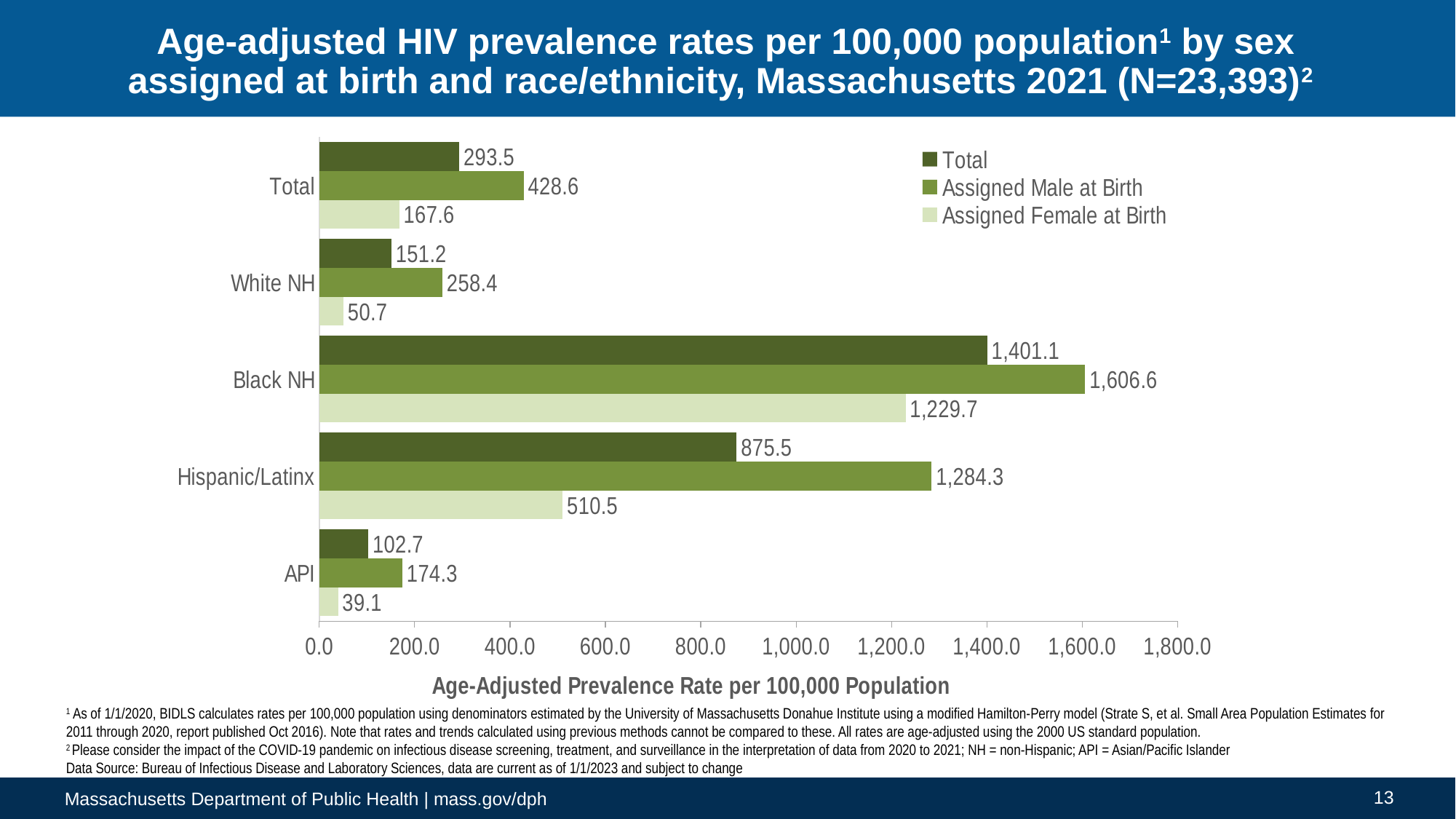
How many series does the legend list? 3 What is the Assigned Female at Birth value for White NH? 50.7 What is the Assigned Female at Birth value for API? 39.1 What is the Total value for Hispanic/Latinx? 875.5 What kind of chart is shown on the slide? Bar chart What is the difference between the Assigned Male at Birth and Assigned Female at Birth values for Hispanic/Latinx? 773.8 What is the Assigned Male at Birth value for Black NH? 1,606.6 How many categories are shown on the y axis? 5 Which race/ethnicity category has the highest Total value? Black NH What is the x axis title of the chart? Age-Adjusted Prevalence Rate per 100,000 Population Which category has the lowest Assigned Male at Birth value? API Which is larger: the Assigned Female at Birth value for Black NH or the Assigned Male at Birth value for Hispanic/Latinx? Assigned Male at Birth value for Hispanic/Latinx